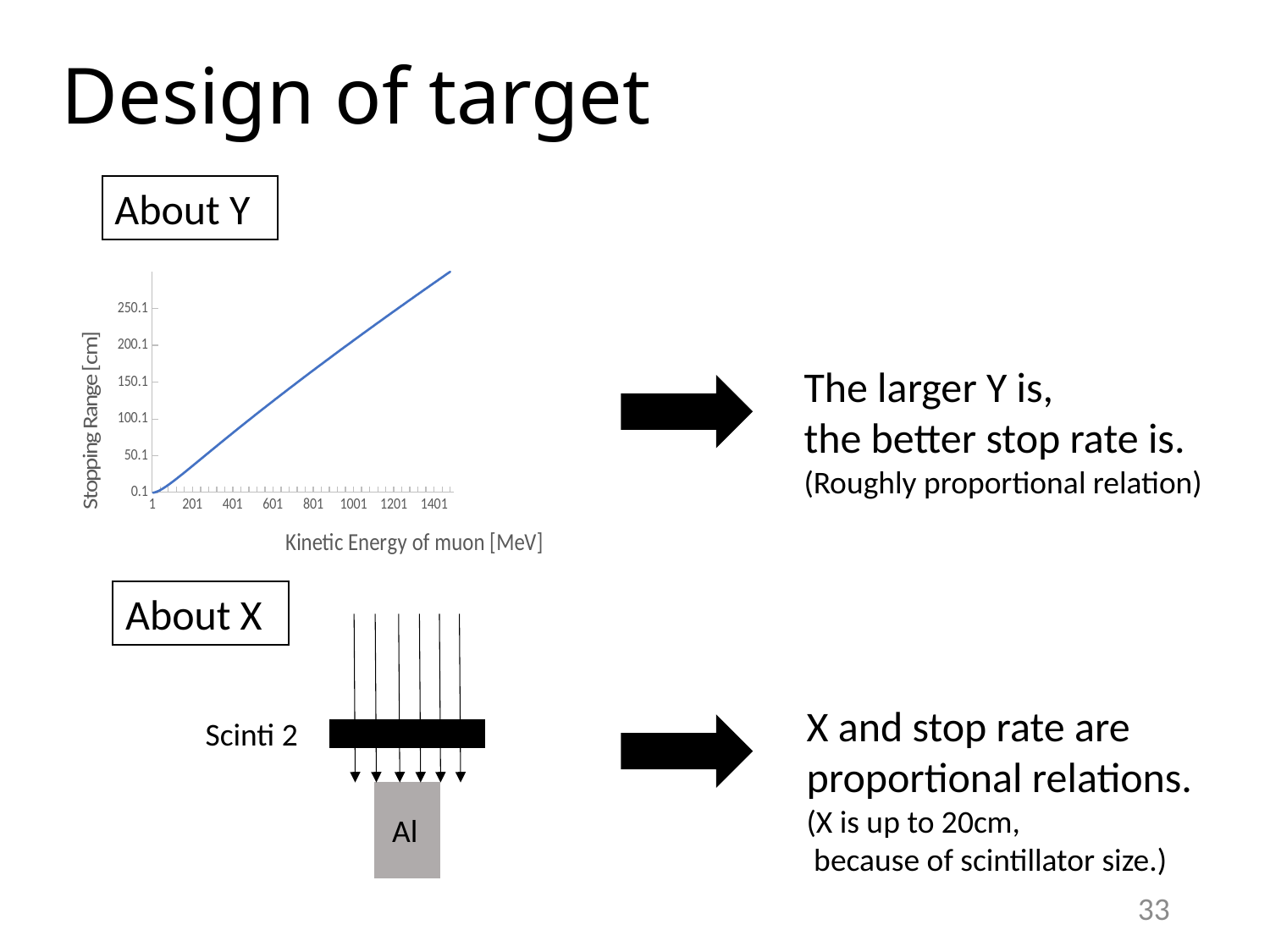
In the chart under "About Y", what is the highest value labelled on the y axis? 250.1 In the chart under "About Y", is the stopping range at a kinetic energy of 1201 MeV greater or less than 200.1 cm? greater In the chart under "About Y", does the stopping range rise or fall as the kinetic energy of the muon increases? rise What is the label of the x axis of the chart under "About Y"? Kinetic Energy of muon [MeV] In the chart under "About Y", is the stopping range at a kinetic energy of 201 MeV greater or less than 100.1 cm? less What kind of chart is shown under "About Y"? line chart In the chart under "About Y", is the stopping range at a kinetic energy of 401 MeV greater or less than 150.1 cm? less How many data series are plotted in the chart under "About Y"? 1 In the chart under "About Y", which has the larger stopping range: a kinetic energy of 201 MeV or 1201 MeV? 1201 MeV What is the label of the y axis of the chart under "About Y"? Stopping Range [cm]